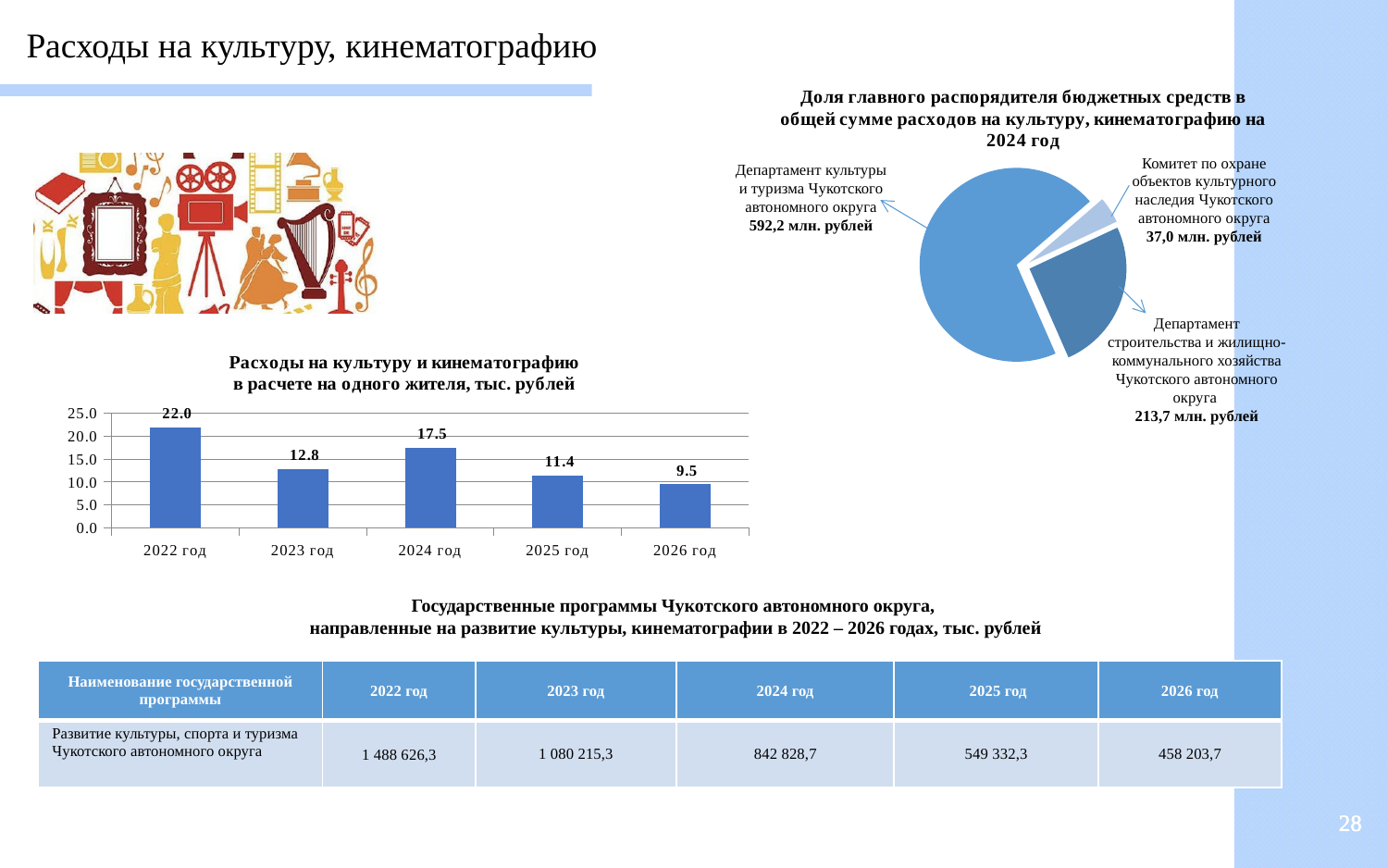
How many years are shown in the bar chart 'Расходы на культуру и кинематографию в расчете на одного жителя'? 5 What type of chart is 'Расходы на культуру и кинематографию в расчете на одного жителя'? Bar chart In the bar chart 'Расходы на культуру и кинематографию в расчете на одного жителя', what is the difference between the values for 2022 год and 2023 год? 9.2 In the bar chart 'Расходы на культуру и кинематографию в расчете на одного жителя', which year has the lowest value? 2026 год How many slices does the pie chart 'Доля главного распорядителя бюджетных средств' have? 3 In the pie chart 'Доля главного распорядителя бюджетных средств', what is the value for Комитет по охране объектов культурного наследия Чукотского автономного округа? 37,0 млн. рублей In the bar chart 'Расходы на культуру и кинематографию в расчете на одного жителя', which year has the highest value? 2022 год In the bar chart 'Расходы на культуру и кинематографию в расчете на одного жителя', what is the value for 2024 год? 17.5 In the pie chart 'Доля главного распорядителя бюджетных средств', which category has the largest slice? Департамент культуры и туризма Чукотского автономного округа In the bar chart 'Расходы на культуру и кинематографию в расчете на одного жителя', what is the value for 2022 год? 22.0 In the pie chart 'Доля главного распорядителя бюджетных средств', what is the value for Департамент культуры и туризма Чукотского автономного округа? 592,2 млн. рублей In the bar chart 'Расходы на культуру и кинематографию в расчете на одного жителя', which is larger: the value for 2023 год or 2025 год? 2023 год